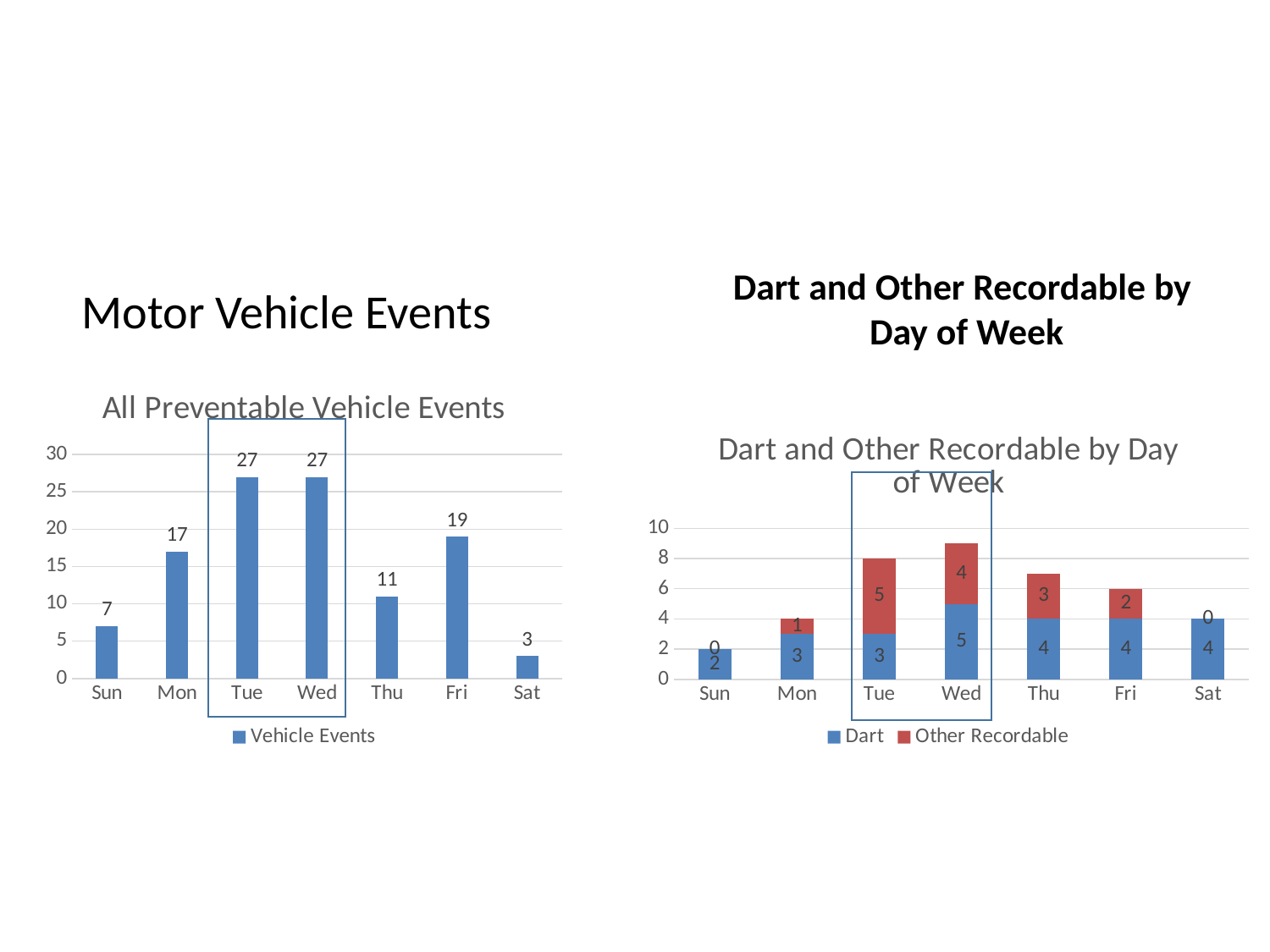
In the 'Dart and Other Recordable by Day of Week' chart, what is the Other Recordable value for Tue? 5 In the 'All Preventable Vehicle Events' chart, which is larger, the value for Sun or the value for Thu? Thu What kind of chart is 'All Preventable Vehicle Events'? Bar chart How many series does the legend of the 'Dart and Other Recordable by Day of Week' chart list? 2 In the 'All Preventable Vehicle Events' chart, which day has the lowest value? Sat In the 'Dart and Other Recordable by Day of Week' chart, what colour represents the Other Recordable series? Red How many days are shown on the x axis of the 'All Preventable Vehicle Events' chart? 7 In the 'All Preventable Vehicle Events' chart, what is the difference between the values for Fri and Thu? 8 In the 'Dart and Other Recordable by Day of Week' chart, what is the Dart value for Wed? 5 In the 'Dart and Other Recordable by Day of Week' chart, which day has the highest total stacked bar? Wed In the 'All Preventable Vehicle Events' chart, what is the value for Mon? 17 In the 'Dart and Other Recordable by Day of Week' chart, what is the total of the stacked bar for Wed? 9